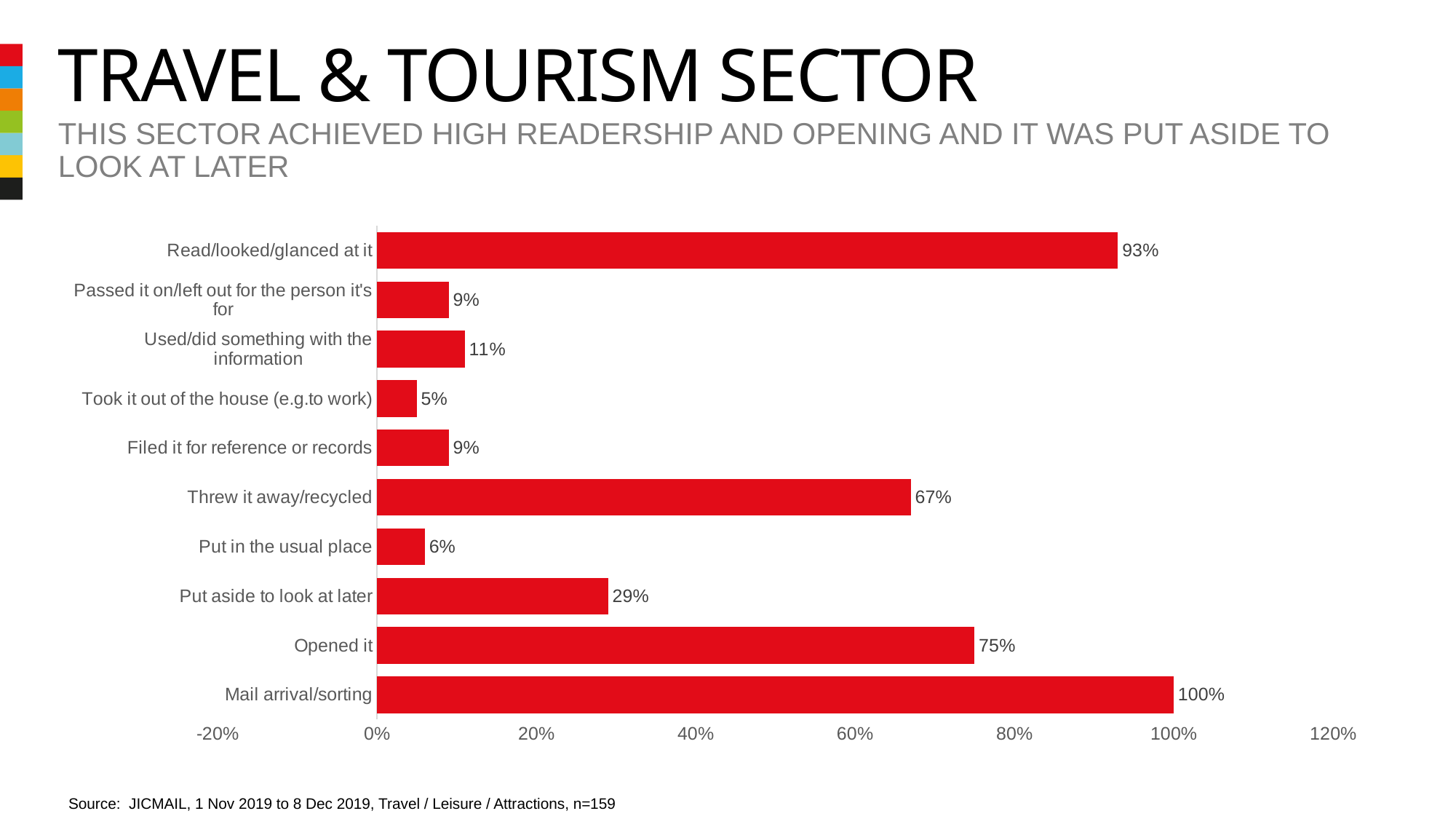
What is the value for "Put aside to look at later"? 29% Which category has the lowest value? Took it out of the house (e.g.to work) What kind of chart is shown on the slide? Bar chart What colour are the bars in the chart? Red How many categories are shown in the chart? 10 What is the difference between "Mail arrival/sorting" and "Opened it"? 25% What is the value for "Opened it"? 75% Which category has the highest value? Mail arrival/sorting What is the value for "Read/looked/glanced at it"? 93% Which is larger, "Used/did something with the information" or "Put in the usual place"? Used/did something with the information What is the difference between "Read/looked/glanced at it" and "Threw it away/recycled"? 26% What is the value for "Threw it away/recycled"? 67%